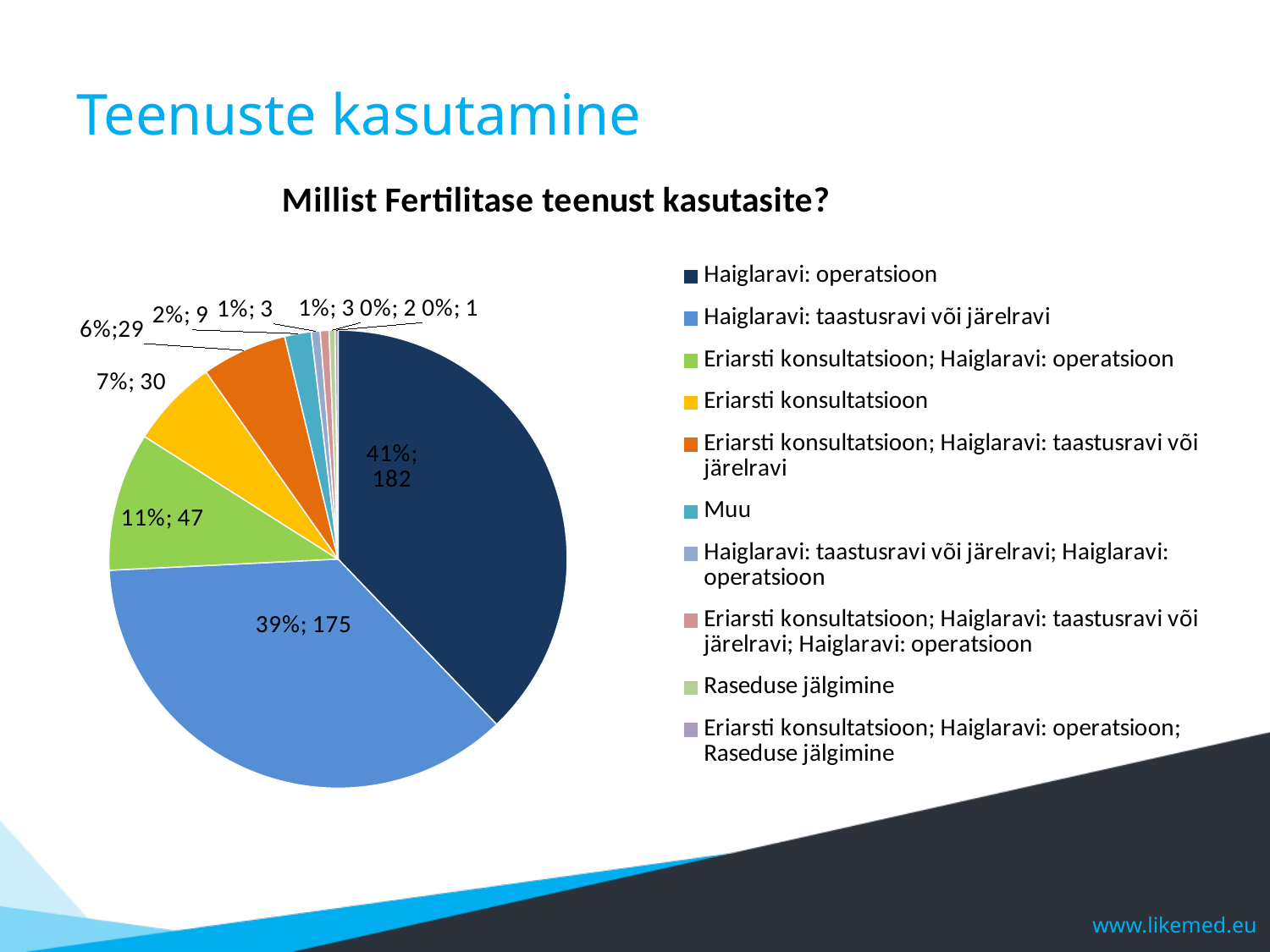
What is the difference in count between 'Haiglaravi: operatsioon' and 'Haiglaravi: taastusravi või järelravi'? 7 What is the count shown for 'Eriarsti konsultatsioon'? 30 What kind of chart is shown on the slide? pie chart What percentage share does 'Haiglaravi: taastusravi või järelravi' have? 39% How many entries does the chart legend list? 10 What is the title of the chart? Millist Fertilitase teenust kasutasite? What is the count shown for 'Haiglaravi: operatsioon'? 182 What percentage share does 'Muu' have? 2% What is the count shown for 'Eriarsti konsultatsioon; Haiglaravi: operatsioon'? 47 Which has a larger count: 'Eriarsti konsultatsioon' or 'Eriarsti konsultatsioon; Haiglaravi: taastusravi või järelravi'? Eriarsti konsultatsioon Which category has the largest slice of the pie? Haiglaravi: operatsioon Which category has the smallest slice of the pie? Eriarsti konsultatsioon; Haiglaravi: operatsioon; Raseduse jälgimine